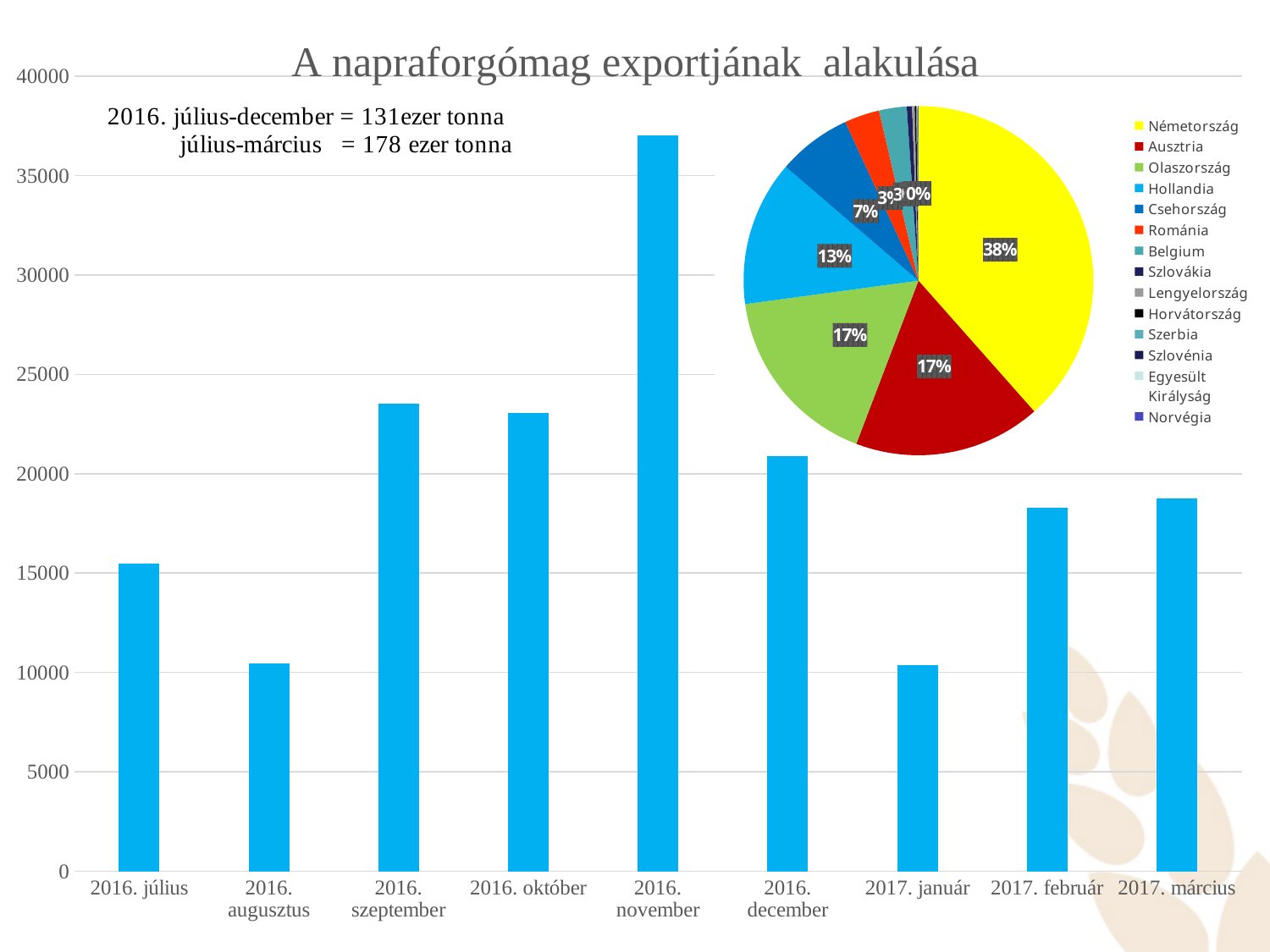
In the pie chart on the right, what is the difference between the share of Németország and the share of Hollandia? 25% What kind of chart is the chart on the left side of the slide, showing monthly values from 2016. július to 2017. március? bar chart In the bar chart on the left, which month has the highest bar? 2016. november In the bar chart on the left, is the value for 2017. február greater or less than 20000? less In the bar chart on the left, which is larger, the value for 2016. november or the value for 2016. december? 2016. november What kind of chart is the chart in the upper right of the slide, showing countries such as Németország and Ausztria? pie chart In the pie chart on the right, what share does Németország have? 38% In the pie chart on the right, how many countries does the legend list? 14 In the bar chart on the left, is the value for 2016. október greater or less than 25000? less In the pie chart on the right, what share does Hollandia have? 13% In the bar chart on the left, how many months are shown on the x axis? 9 In the bar chart on the left, is the value for 2016. november greater or less than 35000? greater